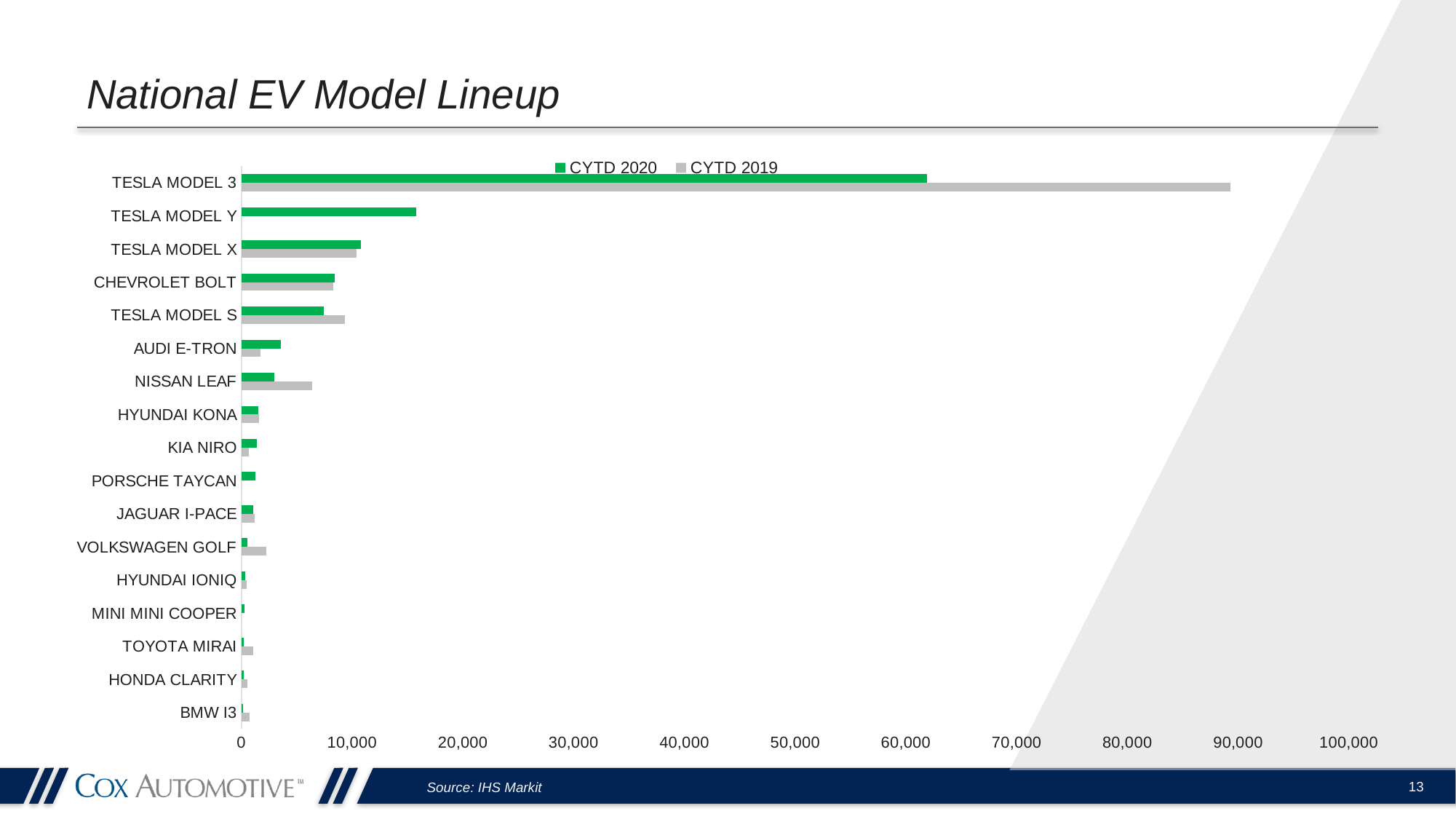
Is the CYTD 2020 value for Tesla Model 3 greater or less than 60,000? greater What colour represents the CYTD 2020 series in the legend? Green Which model has the highest CYTD 2019 value? Tesla Model 3 For Tesla Model 3, which is larger: the CYTD 2020 value or the CYTD 2019 value? CYTD 2019 For Nissan Leaf, which is larger: the CYTD 2020 value or the CYTD 2019 value? CYTD 2019 For Audi e-tron, which is larger: the CYTD 2020 value or the CYTD 2019 value? CYTD 2020 Is the CYTD 2020 value for Tesla Model Y greater or less than 20,000? less Is the CYTD 2019 value for Tesla Model 3 greater or less than 80,000? greater What kind of chart is shown on the slide? Bar chart Which model has the highest CYTD 2020 value? Tesla Model 3 How many series does the legend list? 2 How many EV models are listed on the chart? 17